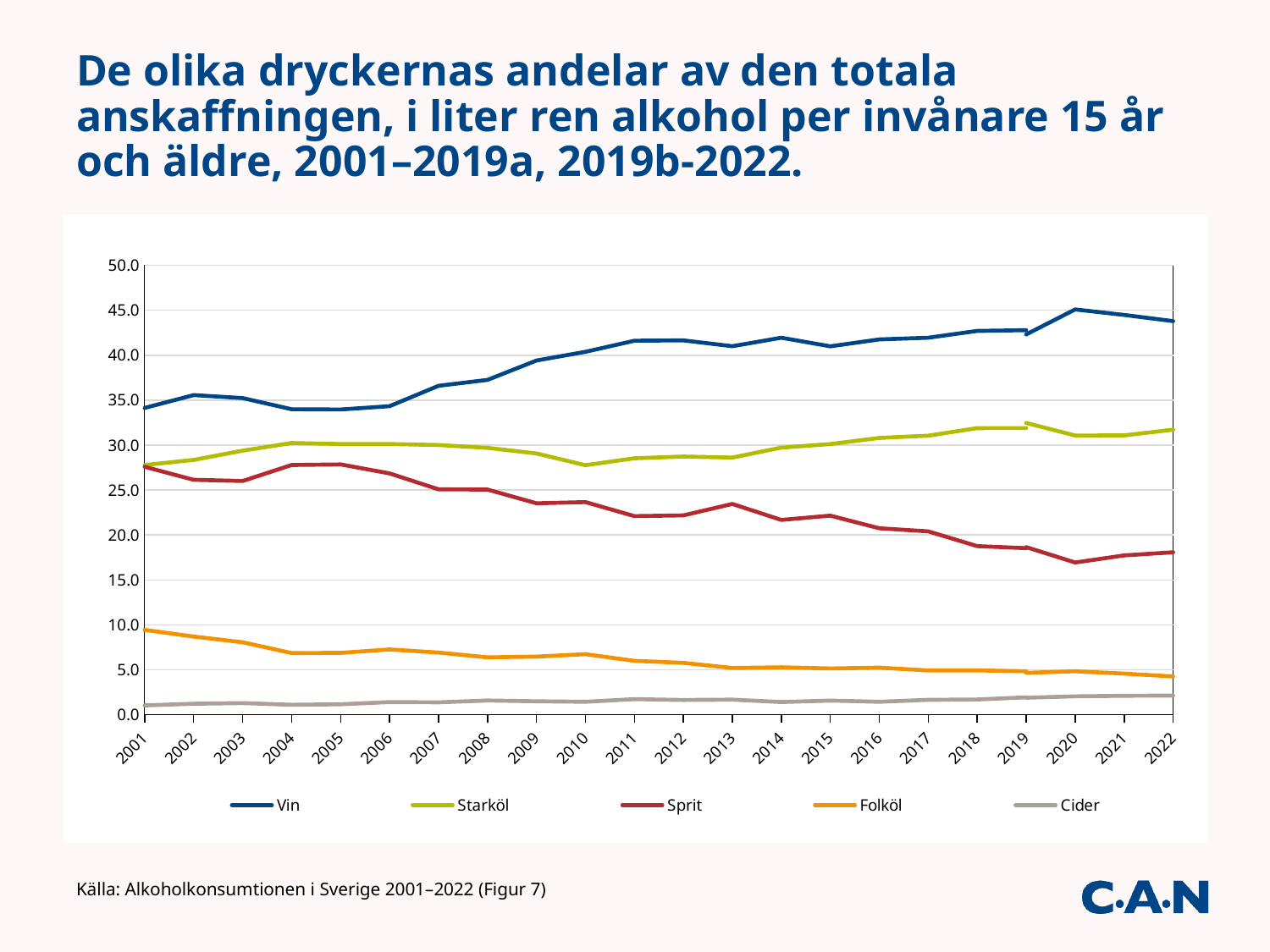
Does the Vin series rise or fall from 2001 to 2022? rise Does the Sprit series rise or fall from 2001 to 2022? fall How many years are labelled on the x axis? 22 Is the value for Sprit in 2022 greater or less than 20? less What colour is the Vin line in the legend? blue How many series does the legend list? 5 Is the value for Folköl in 2001 greater or less than 5? greater Is the value for Vin in 2020 greater or less than 40? greater Which series has the highest value in 2022? Vin Which series has the lowest value across the whole period? Cider What kind of chart is shown on the slide? line chart In 2022, which is larger: Starköl or Sprit? Starköl